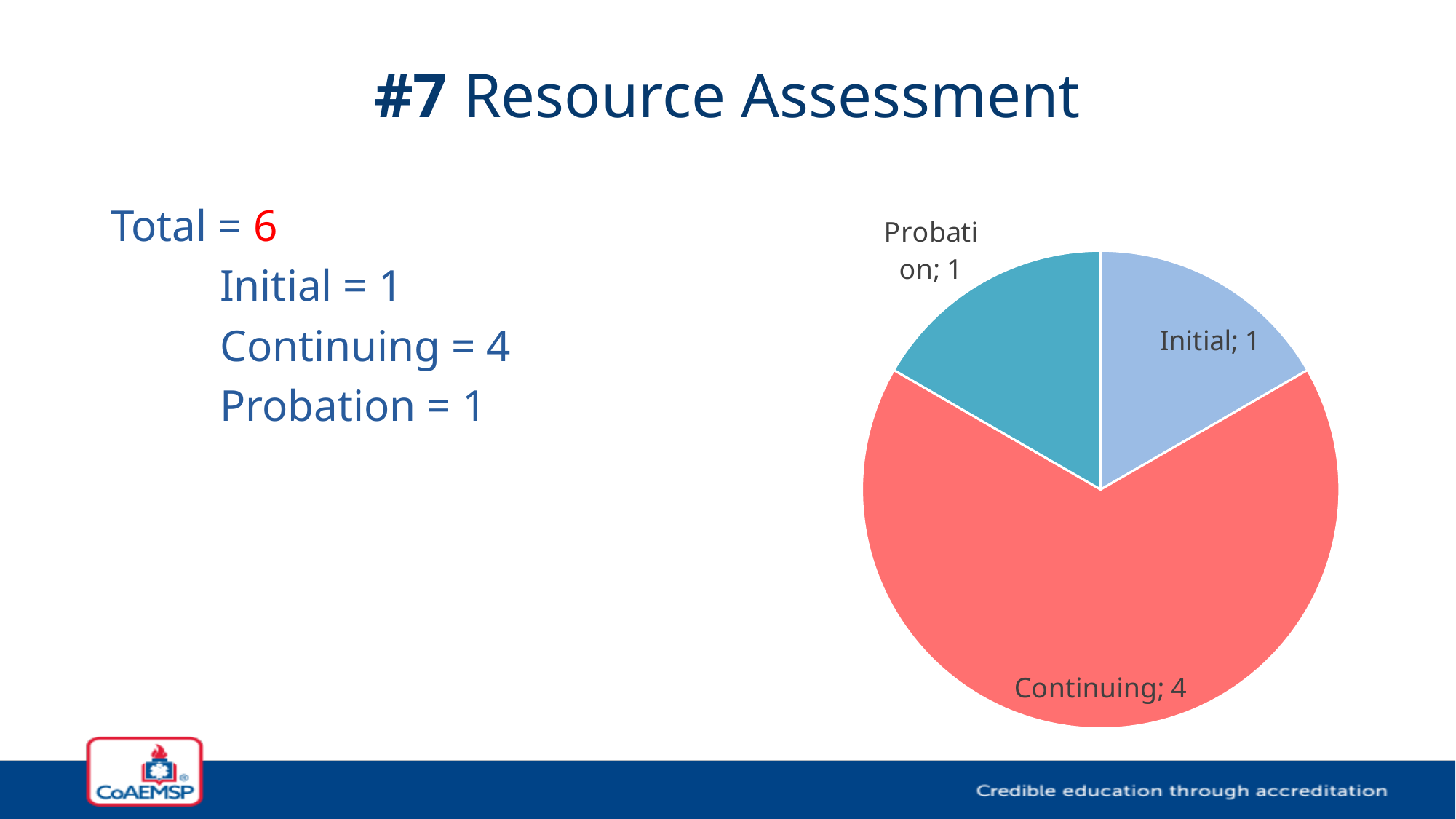
What is the difference between the Continuing and Initial values? 3 What colour is the Continuing slice in the pie chart? red Which is larger, the value for Continuing or the value for Probation? Continuing What share of the pie does the Continuing slice represent? 4 of 6 (two thirds) How many slices does the pie chart have? 3 What is the title of the slide containing the pie chart? #7 Resource Assessment Which category has the largest slice in the pie chart? Continuing What is the value for Continuing in the pie chart? 4 What is the total of all slices in the pie chart? 6 What is the value for Probation in the pie chart? 1 What is the value for Initial in the pie chart? 1 What kind of chart is shown on the slide? pie chart